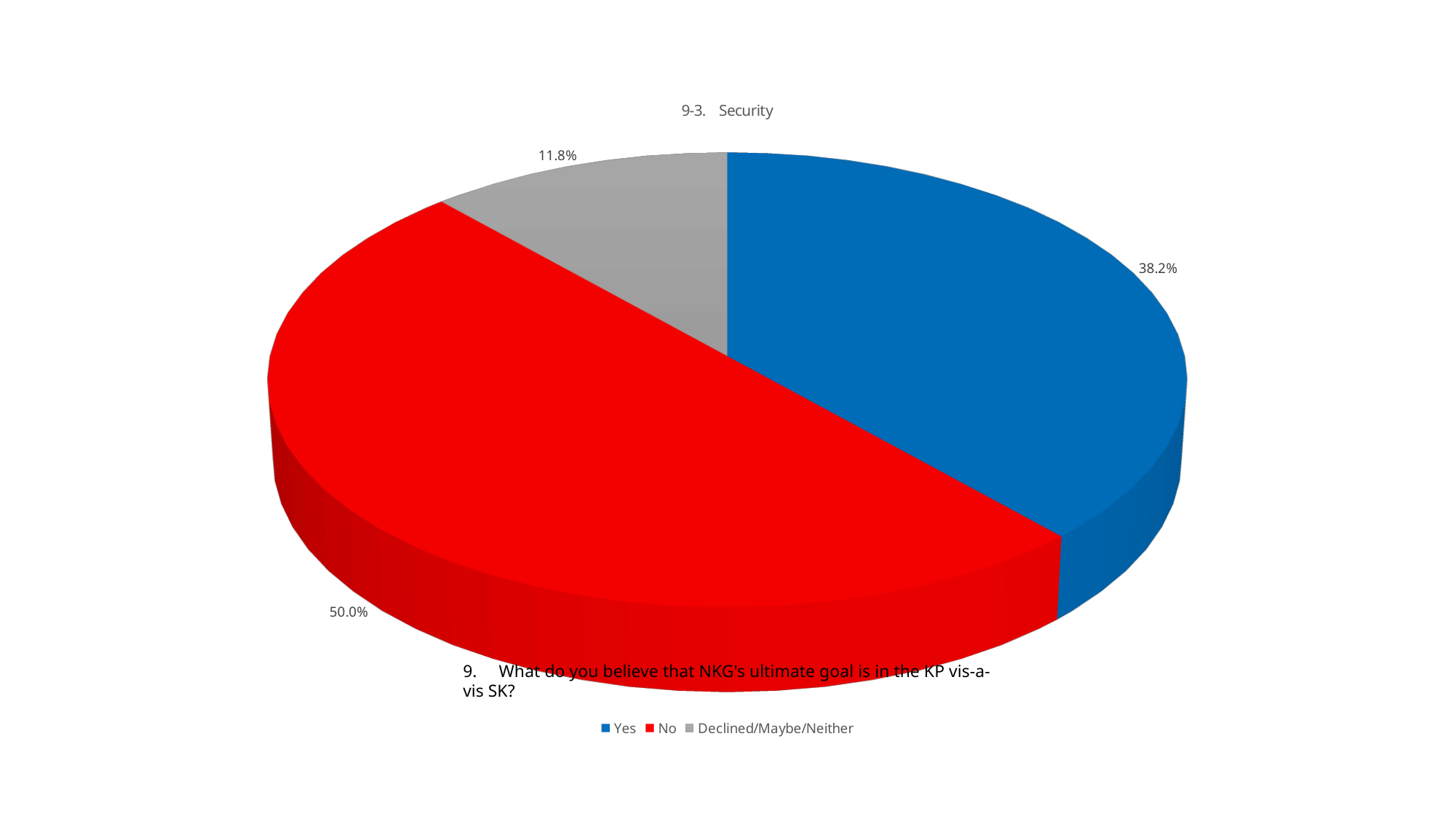
What type of chart is shown on the slide? Pie chart What percentage of the pie is the 'Declined/Maybe/Neither' slice? 11.8% What colour is the 'Declined/Maybe/Neither' slice? Grey How many slices does the pie chart have? 3 Which is larger, the 'Yes' slice or the 'No' slice? No What is the difference in percentage points between the 'No' slice and the 'Yes' slice? 11.8% What percentage of the pie is the 'No' slice? 50.0% What percentage of the pie is the 'Yes' slice? 38.2% Which category has the smallest share of the pie? Declined/Maybe/Neither What is the title of the chart? 9-3. Security How many entries does the legend list? 3 Which category has the largest share of the pie? No